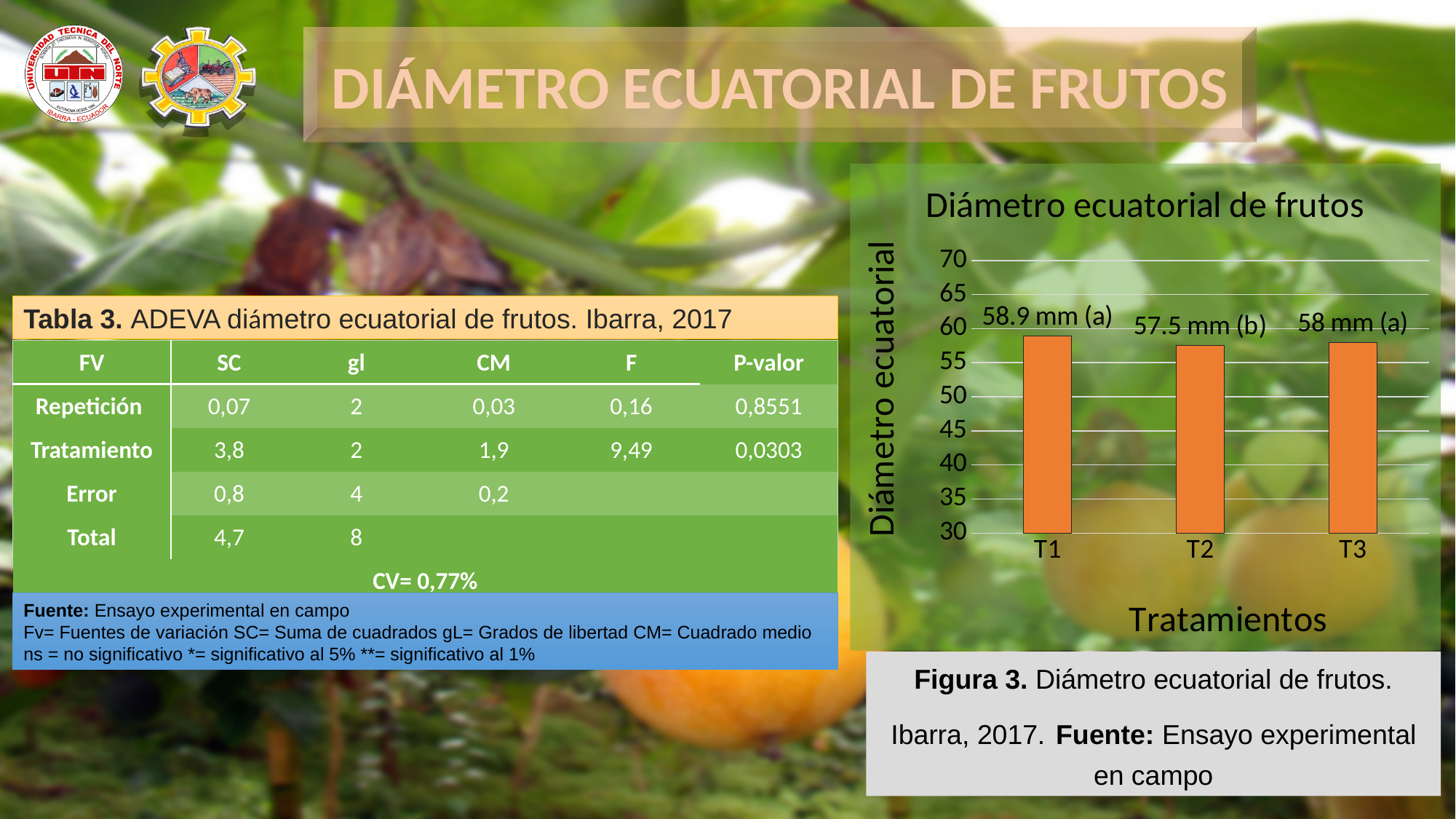
Which is larger, the value for T1 or the value for T3? T1 How many treatments are shown in the chart? 3 Is the value for T2 greater or less than 50? greater What is the difference between the values for T1 and T2? 1.4 mm What is the value for T3 in the chart? 58 mm Which treatment has the lowest equatorial diameter? T2 What is the label of the x axis of the chart? Tratamientos What is the value for T1 in the chart? 58.9 mm What kind of chart is shown on the slide? bar chart What is the value for T2 in the chart? 57.5 mm Which treatment has the highest equatorial diameter? T1 What is the difference between the values for T3 and T2? 0.5 mm